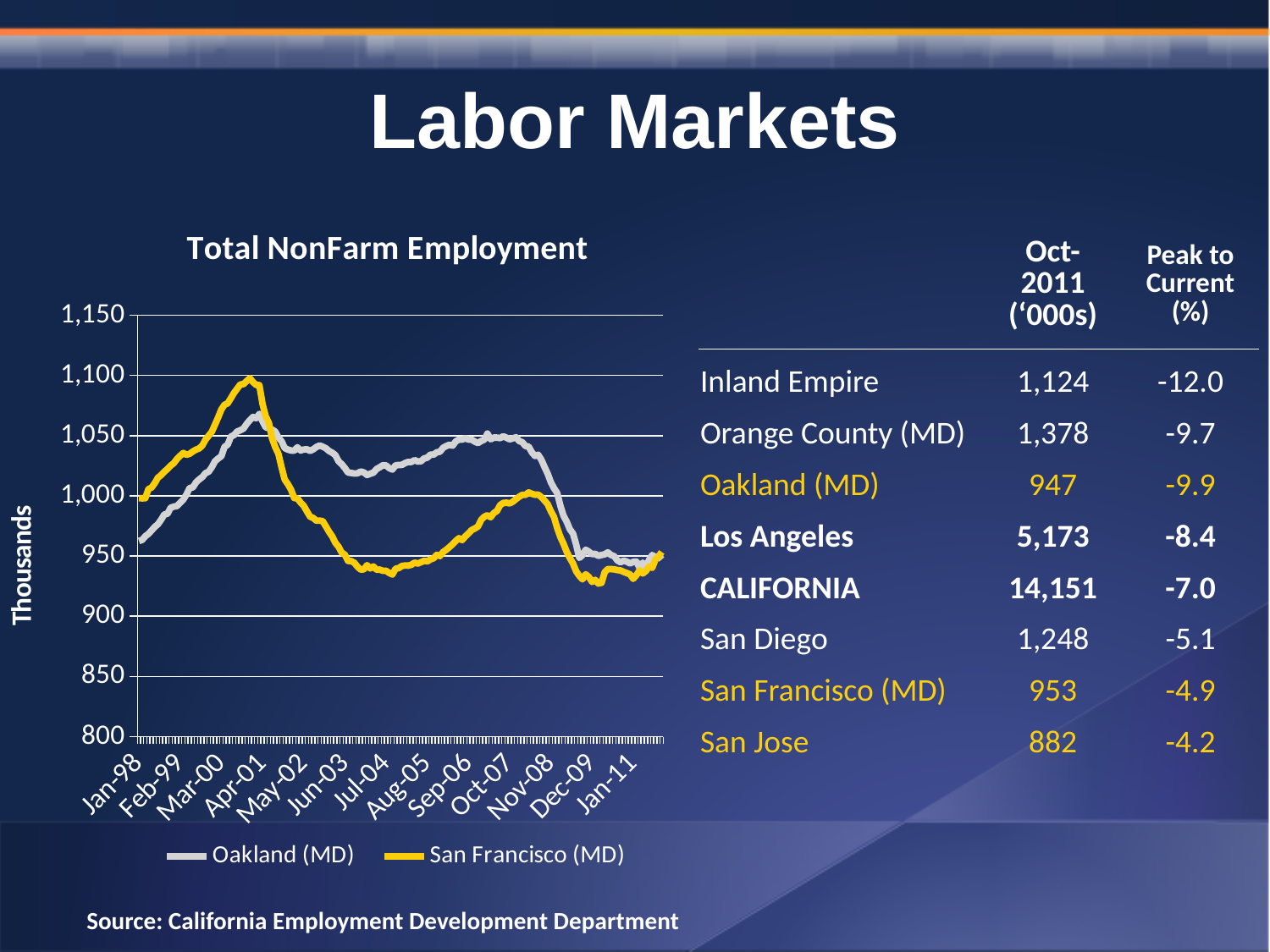
In the Total NonFarm Employment chart, is the peak value for Oakland (MD) around Apr-01 greater or less than 1,050? greater How many series does the legend of the Total NonFarm Employment chart list? 2 In the Total NonFarm Employment chart, does the San Francisco (MD) series rise or fall between Apr-01 and Jul-04? fall In the Total NonFarm Employment chart, which series is higher around Oct-07, Oakland (MD) or San Francisco (MD)? Oakland (MD) What is the title of the chart on the slide? Total NonFarm Employment In the Total NonFarm Employment chart, which series is higher around Apr-01, Oakland (MD) or San Francisco (MD)? San Francisco (MD) In the Total NonFarm Employment chart, is the lowest value for San Francisco (MD) around Jul-04 greater or less than 950? less What is the label on the vertical axis of the Total NonFarm Employment chart? Thousands In the Total NonFarm Employment chart, is the value for Oakland (MD) at Jan-98 greater or less than 1,000? less In the Total NonFarm Employment chart, does the Oakland (MD) series rise or fall between Jan-98 and Apr-01? rise What kind of chart is the Total NonFarm Employment chart? line chart